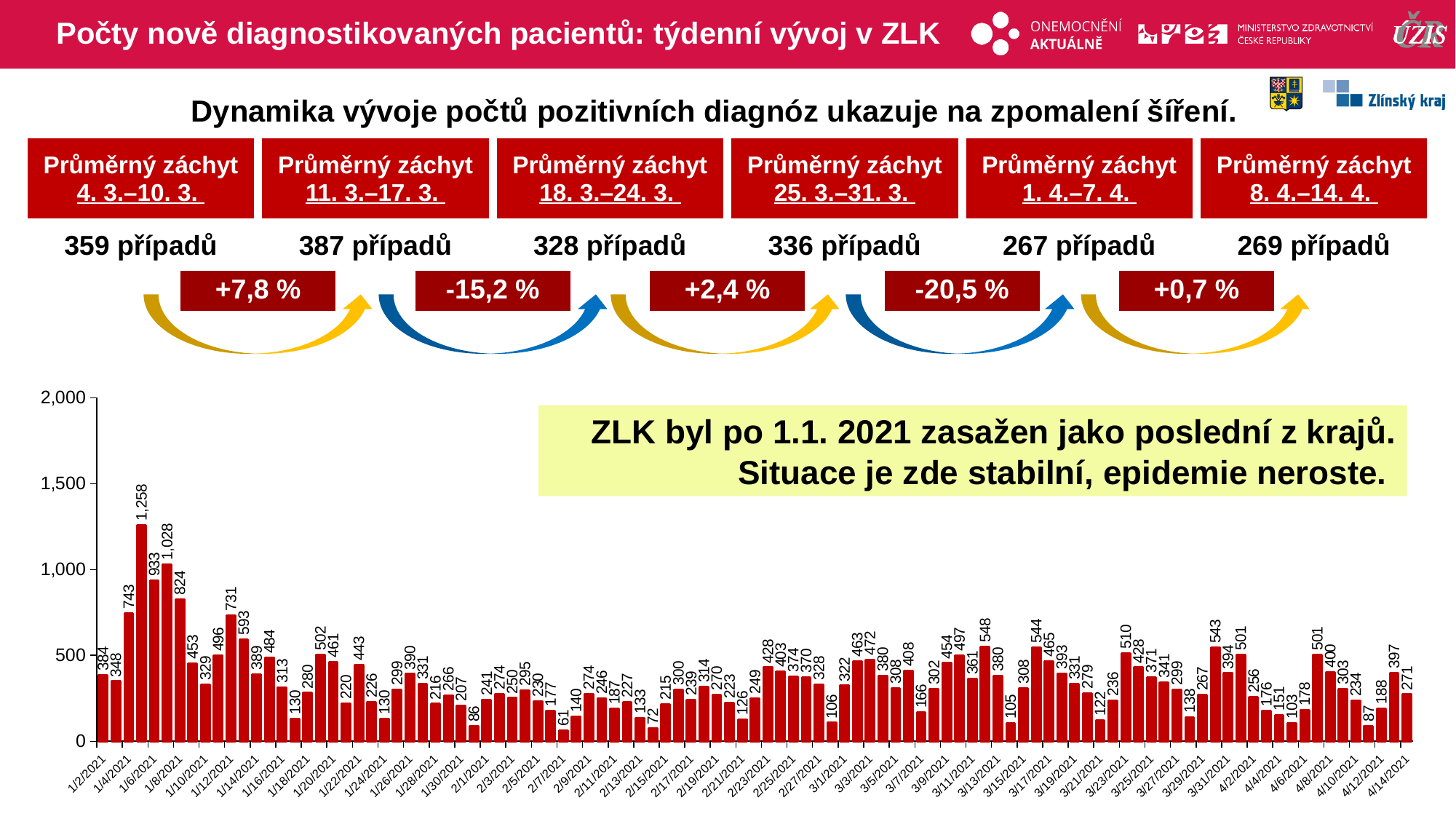
What is the value for 1/8/2021 in the bar chart? 824 What type of chart is shown on the slide? bar chart What is the value for 1/2/2021 in the bar chart? 384 What is the highest value shown on the y axis of the bar chart? 2,000 What is the value for 1/4/2021 in the bar chart? 743 What is the lowest value shown in the bar chart? 61 Is the value for 1/6/2021 in the bar chart greater or less than 500? greater Which is larger in the bar chart, the value for 1/4/2021 or the value for 1/8/2021? 1/8/2021 What is the difference between the value for 1/2/2021 and the value for 4/14/2021 in the bar chart? 113 What is the highest value shown in the bar chart? 1,258 What is the value for 4/14/2021 in the bar chart? 271 Do the values in the bar chart generally rise or fall from the early January peak to April? fall